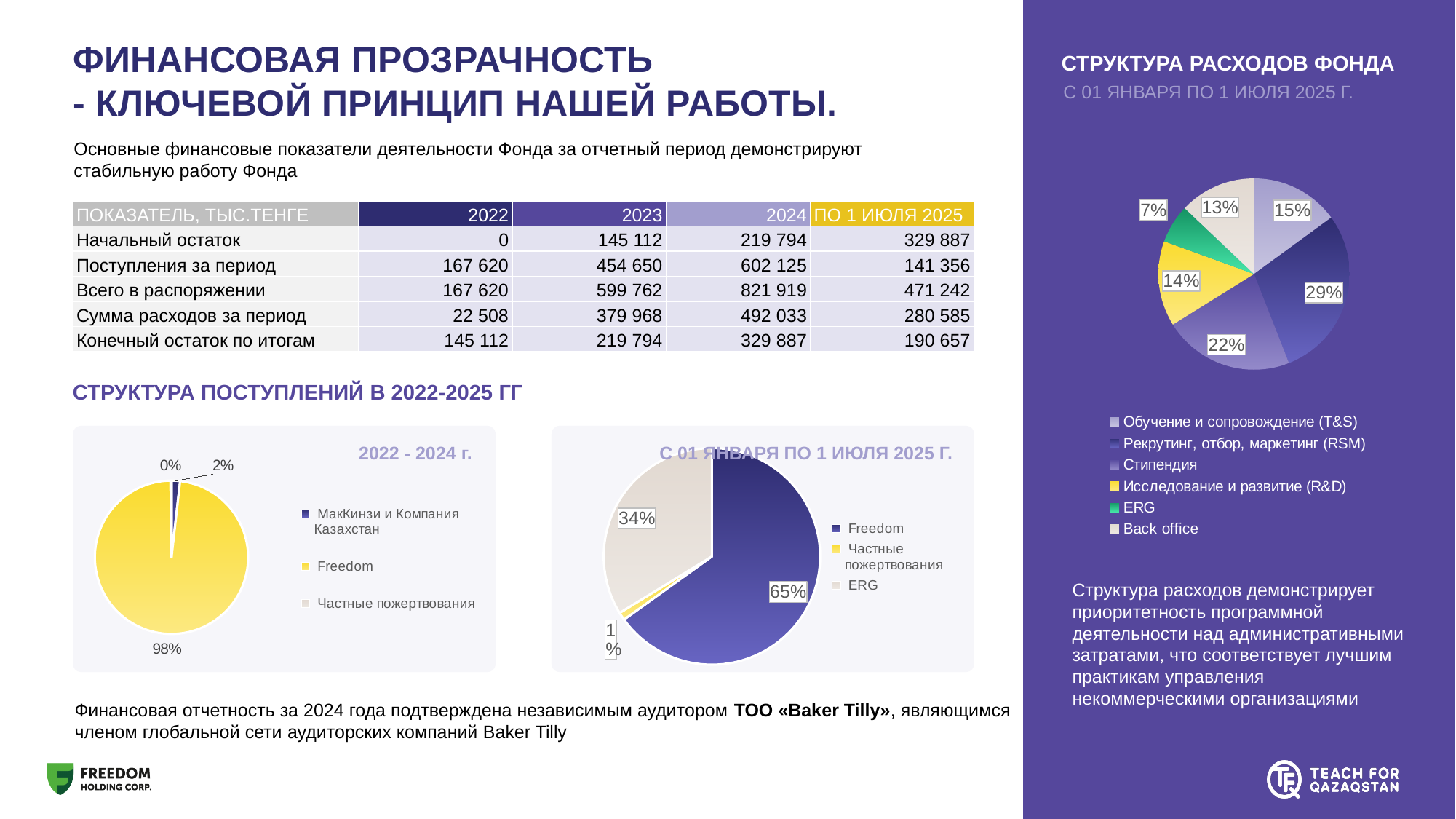
In the 'С 01 ЯНВАРЯ ПО 1 ИЮЛЯ 2025 Г.' pie chart in the middle of the slide, which category has the largest share? Freedom In the 'С 01 ЯНВАРЯ ПО 1 ИЮЛЯ 2025 Г.' pie chart in the middle of the slide, what share is ERG? 34% In the '2022 - 2024 г.' pie chart, what share is Freedom? 98% In the 'СТРУКТУРА РАСХОДОВ ФОНДА' pie chart, which category has the smallest share? ERG What type of chart is used for 'СТРУКТУРА РАСХОДОВ ФОНДА'? Pie chart In the 'СТРУКТУРА РАСХОДОВ ФОНДА' pie chart, which is larger: 'Исследование и развитие (R&D)' or 'Back office'? Исследование и развитие (R&D) In the 'СТРУКТУРА РАСХОДОВ ФОНДА' pie chart, what share is 'Стипендия'? 22% In the 'СТРУКТУРА РАСХОДОВ ФОНДА' pie chart, what is the difference between the shares of 'Обучение и сопровождение (T&S)' and 'Back office'? 2% In the 'СТРУКТУРА РАСХОДОВ ФОНДА' pie chart, what share is 'Рекрутинг, отбор, маркетинг (RSM)'? 29% In the 'СТРУКТУРА РАСХОДОВ ФОНДА' pie chart, which category has the largest share? Рекрутинг, отбор, маркетинг (RSM) In the '2022 - 2024 г.' pie chart, what share is 'МакКинзи и Компания Казахстан'? 2% In the 'СТРУКТУРА РАСХОДОВ ФОНДА' pie chart, how many categories does the legend list? 6